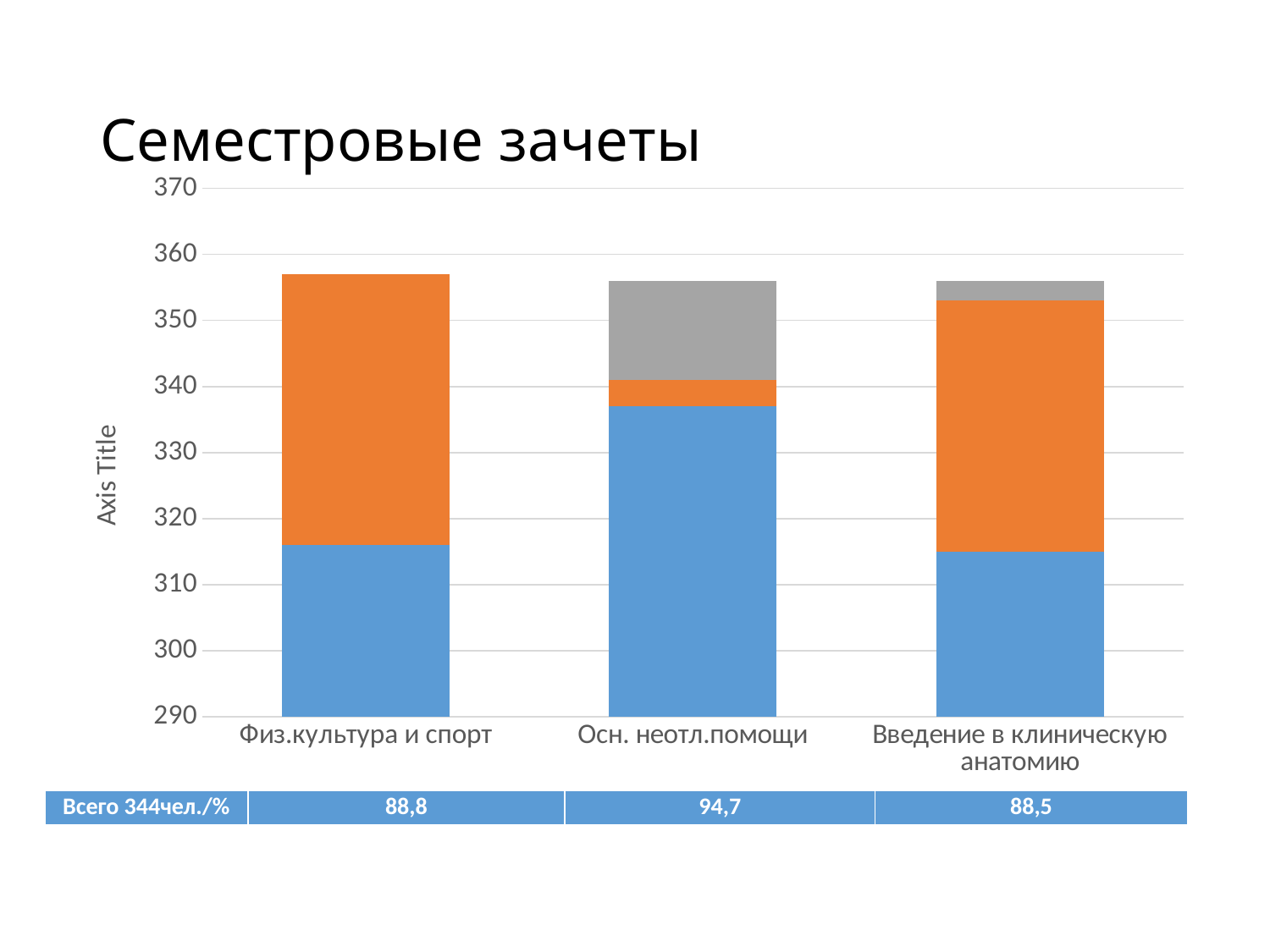
In the table row below the chart, what percentage is shown for Осн. неотл.помощи? 94,7 Is the top of the blue segment for Физ.культура и спорт greater or less than 320? less In the table row below the chart, which category has the lowest percentage? Введение в клиническую анатомию Is the total height of the stacked bar for Введение в клиническую анатомию greater or less than 360? less Which category has the tallest blue segment? Осн. неотл.помощи Which category has the largest grey segment? Осн. неотл.помощи What is the title of the slide above the chart? Семестровые зачеты Is the total height of the stacked bar for Физ.культура и спорт greater or less than 350? greater What kind of chart is shown on the slide? bar chart What is the label on the vertical axis of the chart? Axis Title How many categories are shown on the x axis of the chart? 3